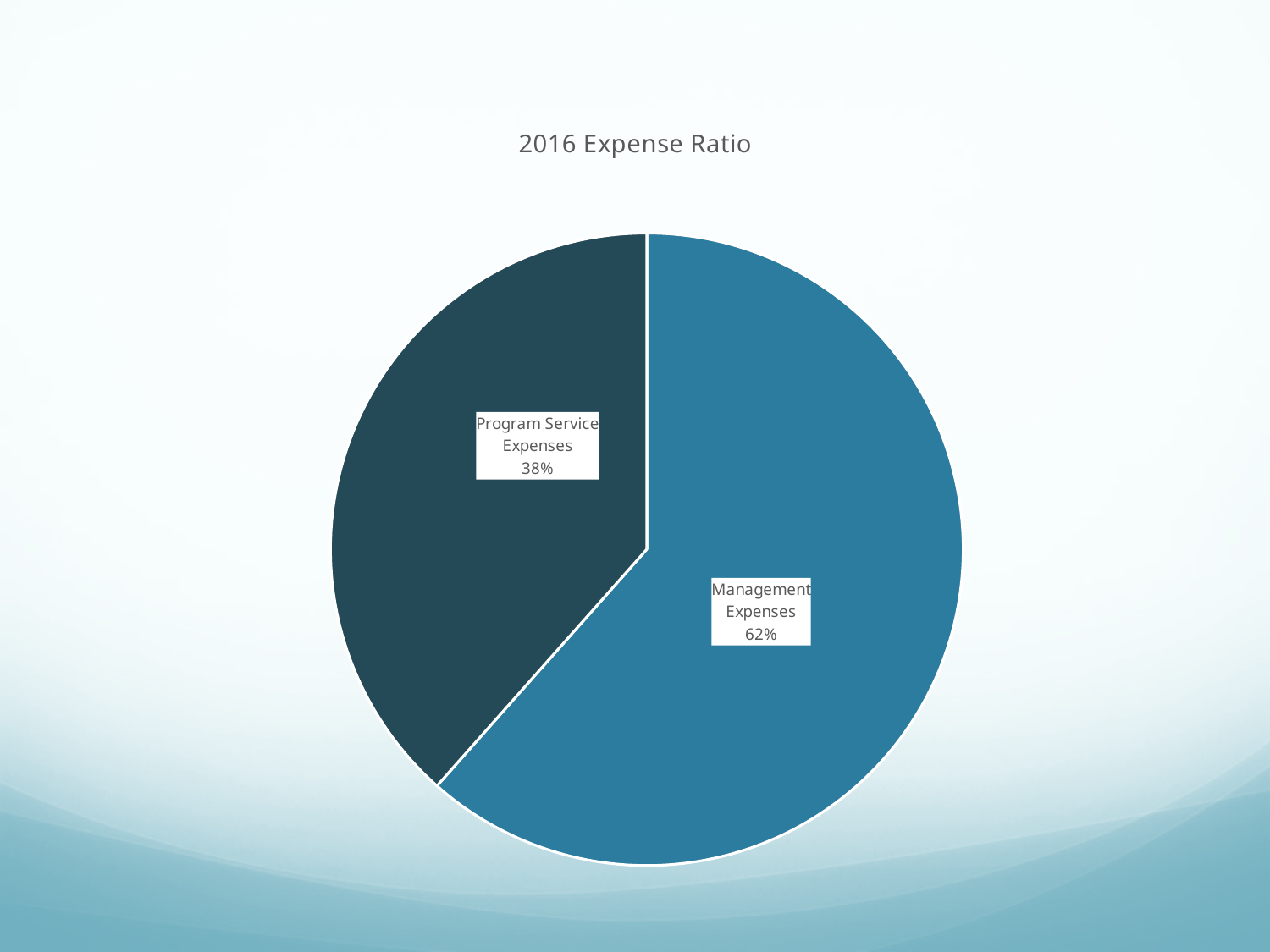
What kind of chart is shown on the slide? pie chart Which slice is shown in the darker colour? Program Service Expenses How many slices does the pie chart have? 2 Is the share for Program Service Expenses greater or less than 50%? less Which slice is the largest? Management Expenses What share of the pie is Management Expenses? 62% What is the difference in percentage points between Management Expenses and Program Service Expenses? 24 What share of the pie is Program Service Expenses? 38% Which is larger, Program Service Expenses or Management Expenses? Management Expenses What is the title of the chart? 2016 Expense Ratio Which slice is the smallest? Program Service Expenses